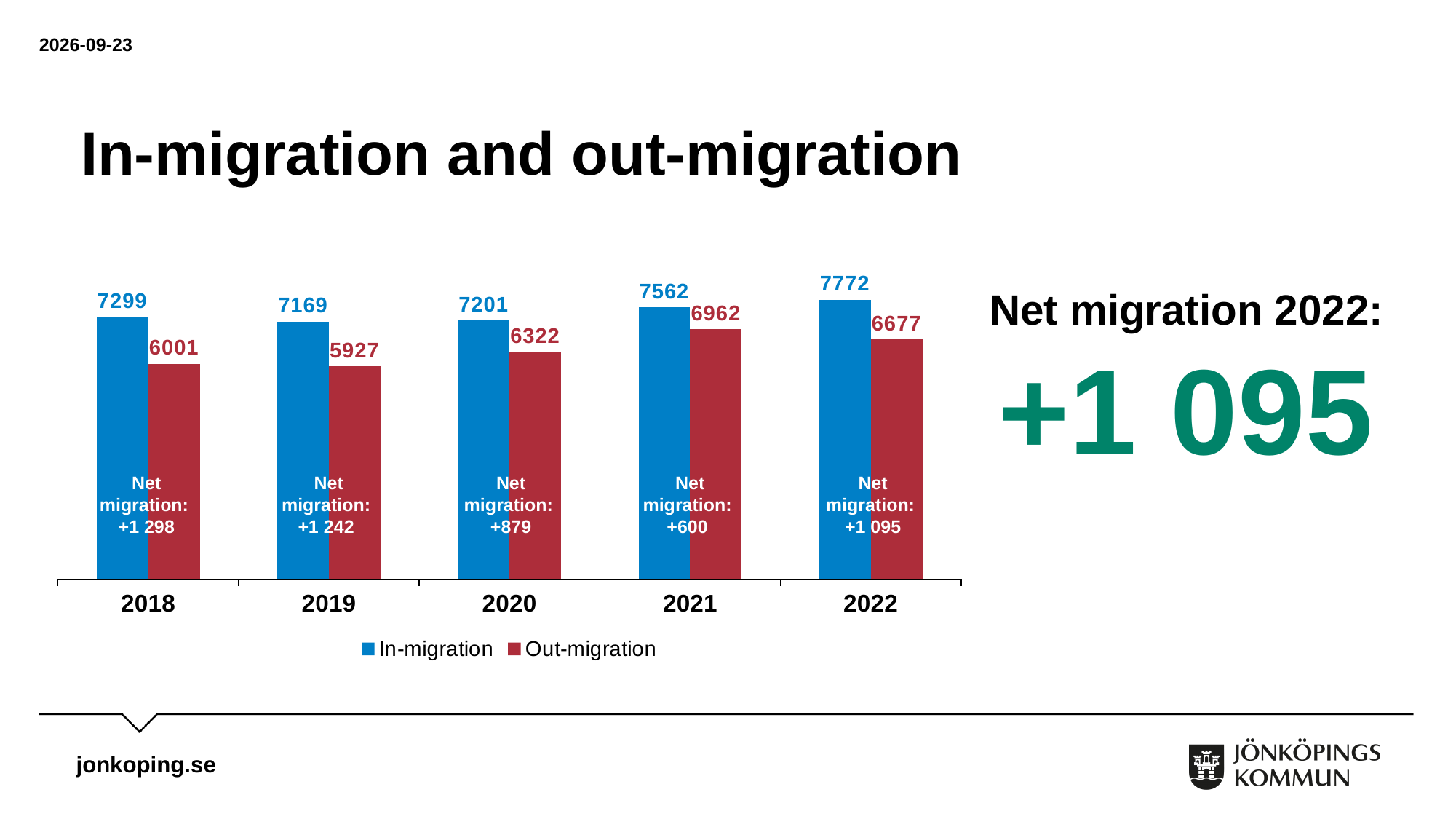
How many years are shown on the x axis? 5 What kind of chart is shown on the slide? Bar chart What was the in-migration value in 2018? 7299 What was the out-migration value in 2019? 5927 Which was larger in 2021, in-migration or out-migration? In-migration Which year had the highest in-migration? 2022 What was the out-migration value in 2021? 6962 Which year had the lowest in-migration? 2019 How many series does the legend list? 2 Which year had the lowest out-migration? 2019 What is the difference between in-migration and out-migration in 2020? 879 What colour are the out-migration bars? Red